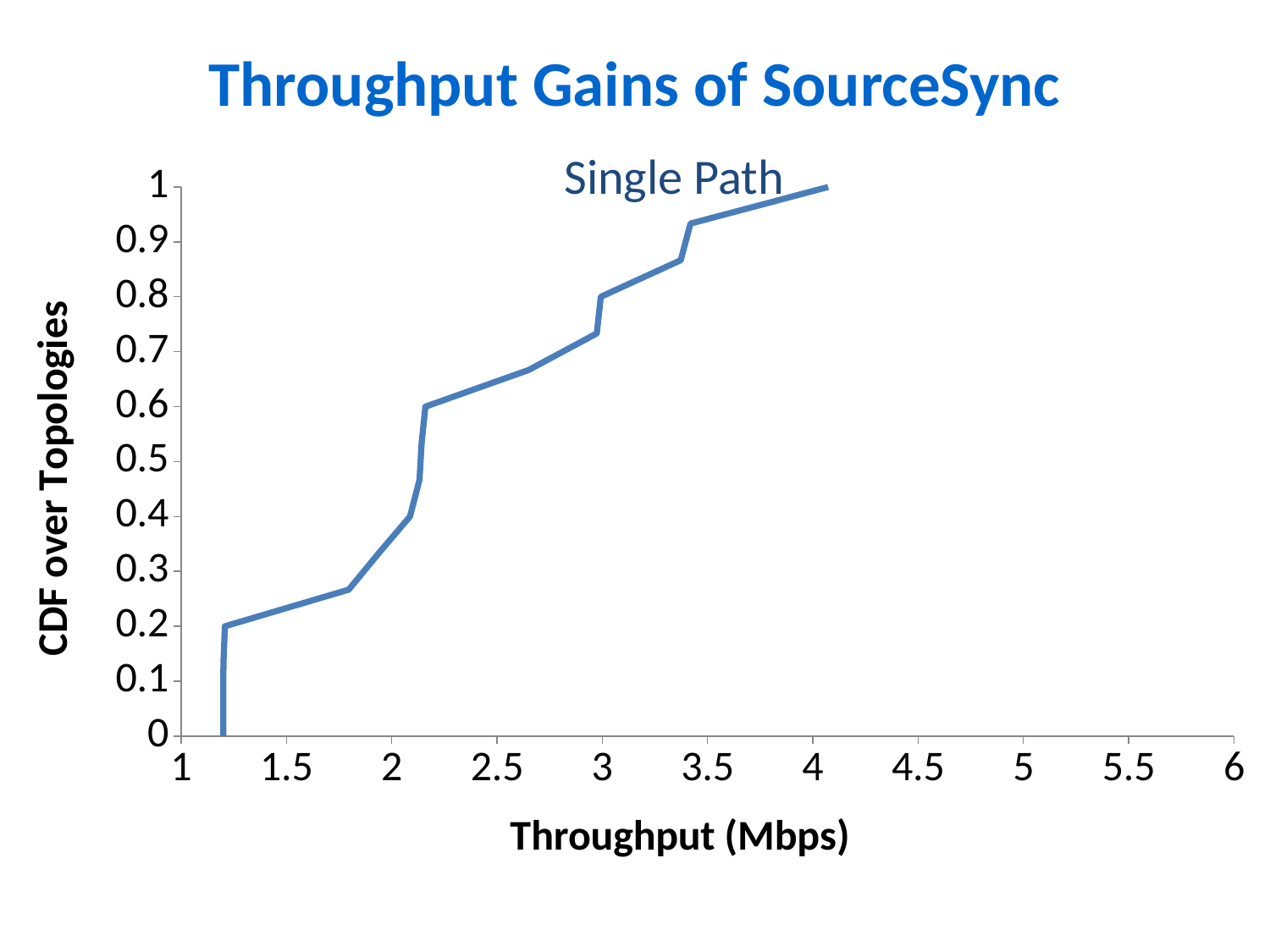
What is the title of the x axis? Throughput (Mbps) What is the label of the plotted series? Single Path Is the CDF value at a throughput of 2.5 Mbps greater or less than 0.5? greater Is the CDF value at a throughput of 1.5 Mbps greater or less than 0.5? less Is the CDF value at a throughput of 2 Mbps greater or less than 0.5? less What kind of chart is shown on the slide? line chart Does the CDF curve rise or fall as throughput increases along the x axis? rise What is the largest value shown on the x axis? 6